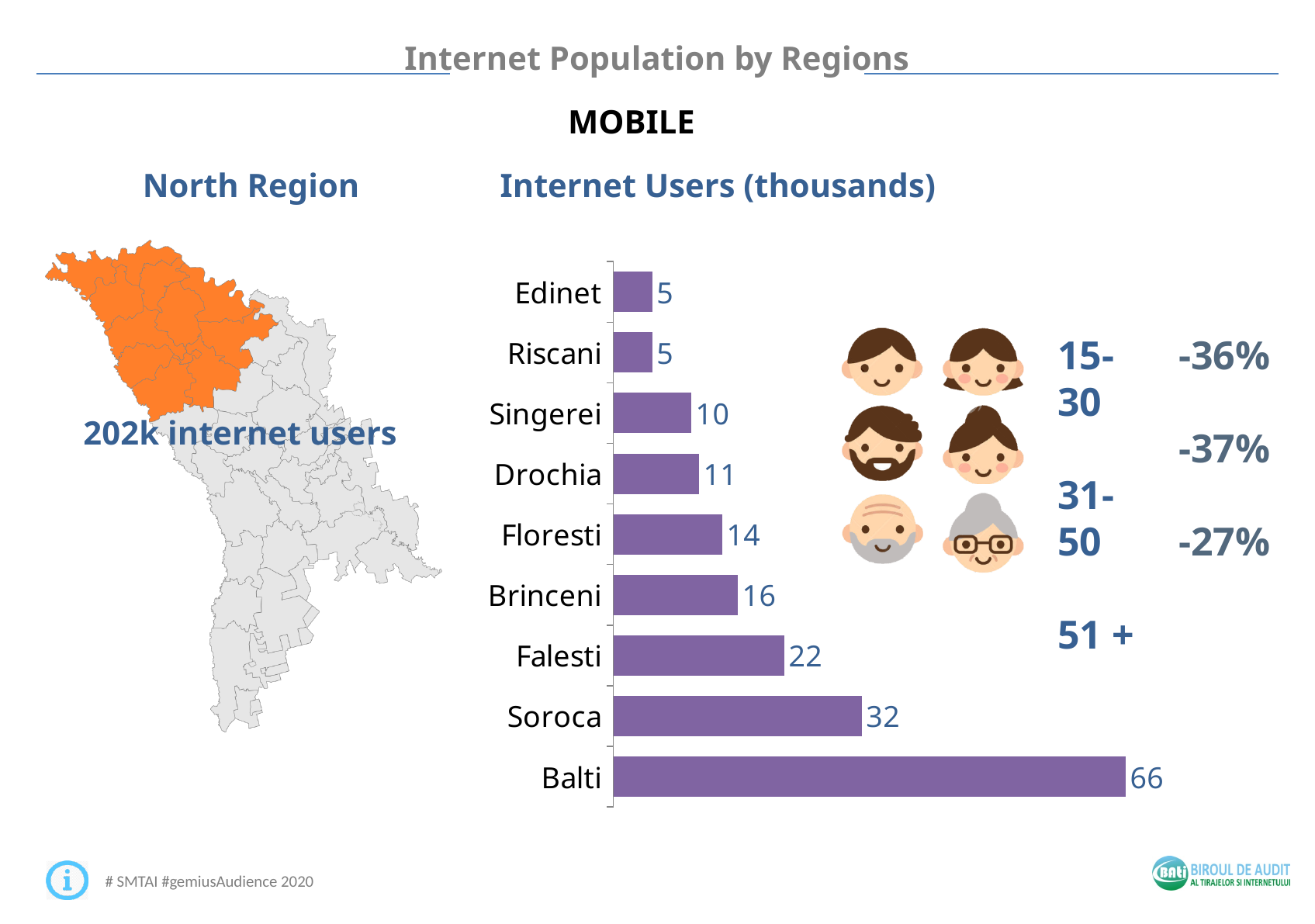
What is the value for Soroca in the Internet Users (thousands) chart? 32 What is the difference between the values for Balti and Soroca in the Internet Users (thousands) chart? 34 What is the difference between the values for Falesti and Singerei in the Internet Users (thousands) chart? 12 What is the value for Floresti in the Internet Users (thousands) chart? 14 What is the value for Balti in the Internet Users (thousands) chart? 66 Which is larger in the Internet Users (thousands) chart, Falesti or Floresti? Falesti Which is larger in the Internet Users (thousands) chart, Brinceni or Drochia? Brinceni How many categories are shown in the Internet Users (thousands) chart? 9 Which category has the highest value in the Internet Users (thousands) chart? Balti What is the title of the chart on the slide? Internet Users (thousands) What kind of chart is the Internet Users (thousands) chart? bar chart What is the value for Drochia in the Internet Users (thousands) chart? 11